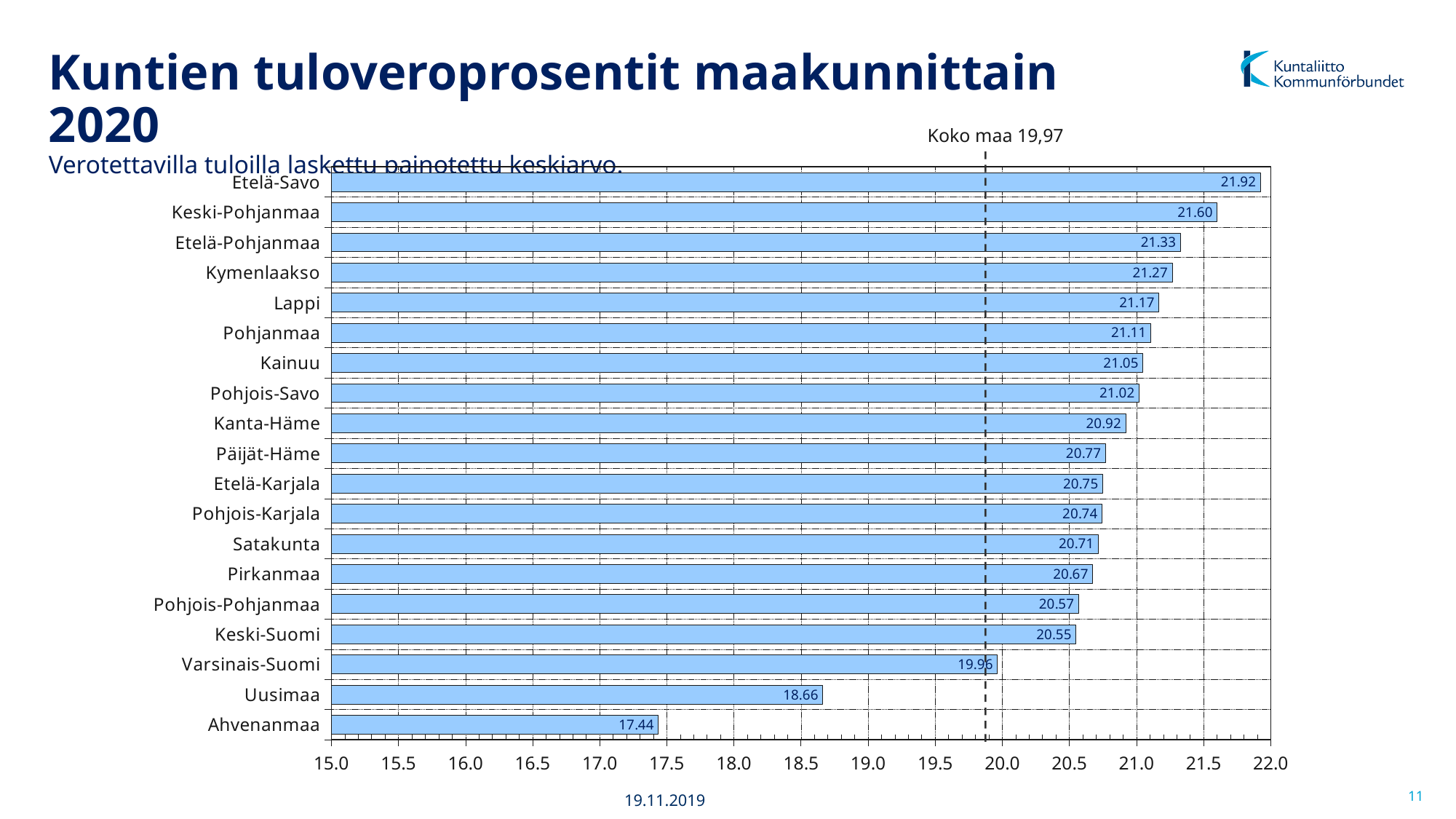
What is the value for Uusimaa? 18.66 What is the difference between the values for Uusimaa and Ahvenanmaa? 1.22 What is the value for Pirkanmaa? 20.67 Which region has the lowest value? Ahvenanmaa Is the value for Uusimaa greater or less than 19.0? less What is the difference between the values for Etelä-Savo and Ahvenanmaa? 4.48 What kind of chart is shown on the slide? bar chart Which is larger, the value for Kymenlaakso or the value for Kainuu? Kymenlaakso Which region has the highest value? Etelä-Savo How many regions are shown in the chart? 19 What is the value for Lappi? 21.17 What is the value for Etelä-Savo? 21.92